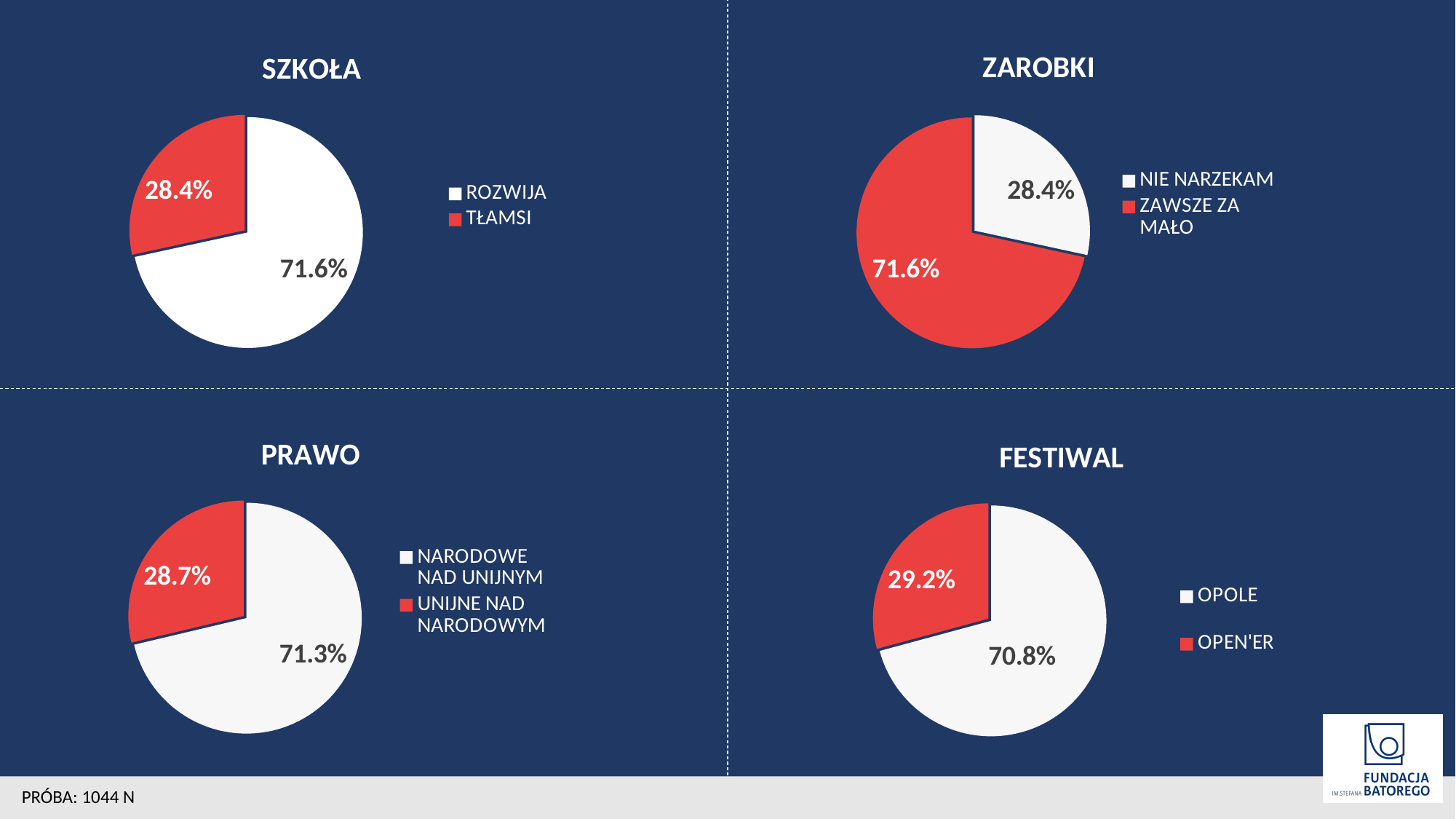
In the PRAWO chart, which slice is the smallest? UNIJNE NAD NARODOWYM In the PRAWO chart, what is the difference between the NARODOWE NAD UNIJNYM and UNIJNE NAD NARODOWYM shares? 42.6% In the ZAROBKI chart, which is larger, NIE NARZEKAM or ZAWSZE ZA MAŁO? ZAWSZE ZA MAŁO In the FESTIWAL chart, what share is labelled for OPOLE? 70.8% What kind of chart is the FESTIWAL chart? Pie chart In the FESTIWAL chart, which slice is the largest? OPOLE In the ZAROBKI chart, what share is labelled for ZAWSZE ZA MAŁO? 71.6% In the SZKOŁA chart, what share is labelled for TŁAMSI? 28.4% In the PRAWO chart, what share is labelled for UNIJNE NAD NARODOWYM? 28.7% How many slices does the SZKOŁA pie chart have? 2 In the SZKOŁA chart, what share is labelled for ROZWIJA? 71.6% In the ZAROBKI chart, what share is labelled for NIE NARZEKAM? 28.4%